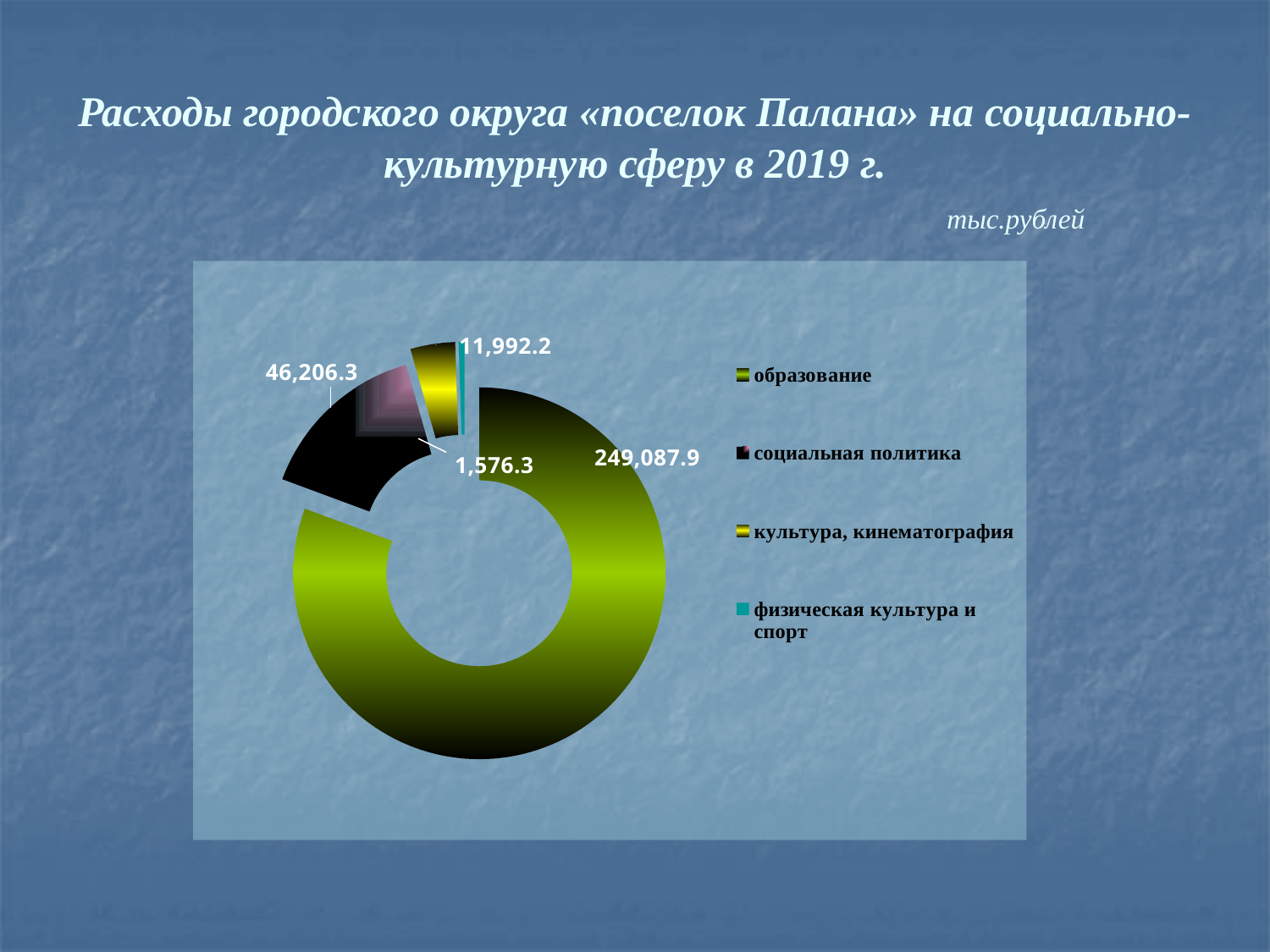
What is the value for социальная политика? 46,206.3 What is the difference between the values for социальная политика and культура, кинематография? 34,214.1 What is the value for культура, кинематография? 11,992.2 What kind of chart is shown on the slide? doughnut chart Which category has the smallest value? физическая культура и спорт Which category has the largest value? образование What unit is stated above the chart? тыс.рублей What is the value for физическая культура и спорт? 1,576.3 Which is larger, the value for культура, кинематография or the value for физическая культура и спорт? культура, кинематография What is the difference between the values for образование and социальная политика? 202,881.6 How many categories does the legend list? 4 What is the value for образование? 249,087.9